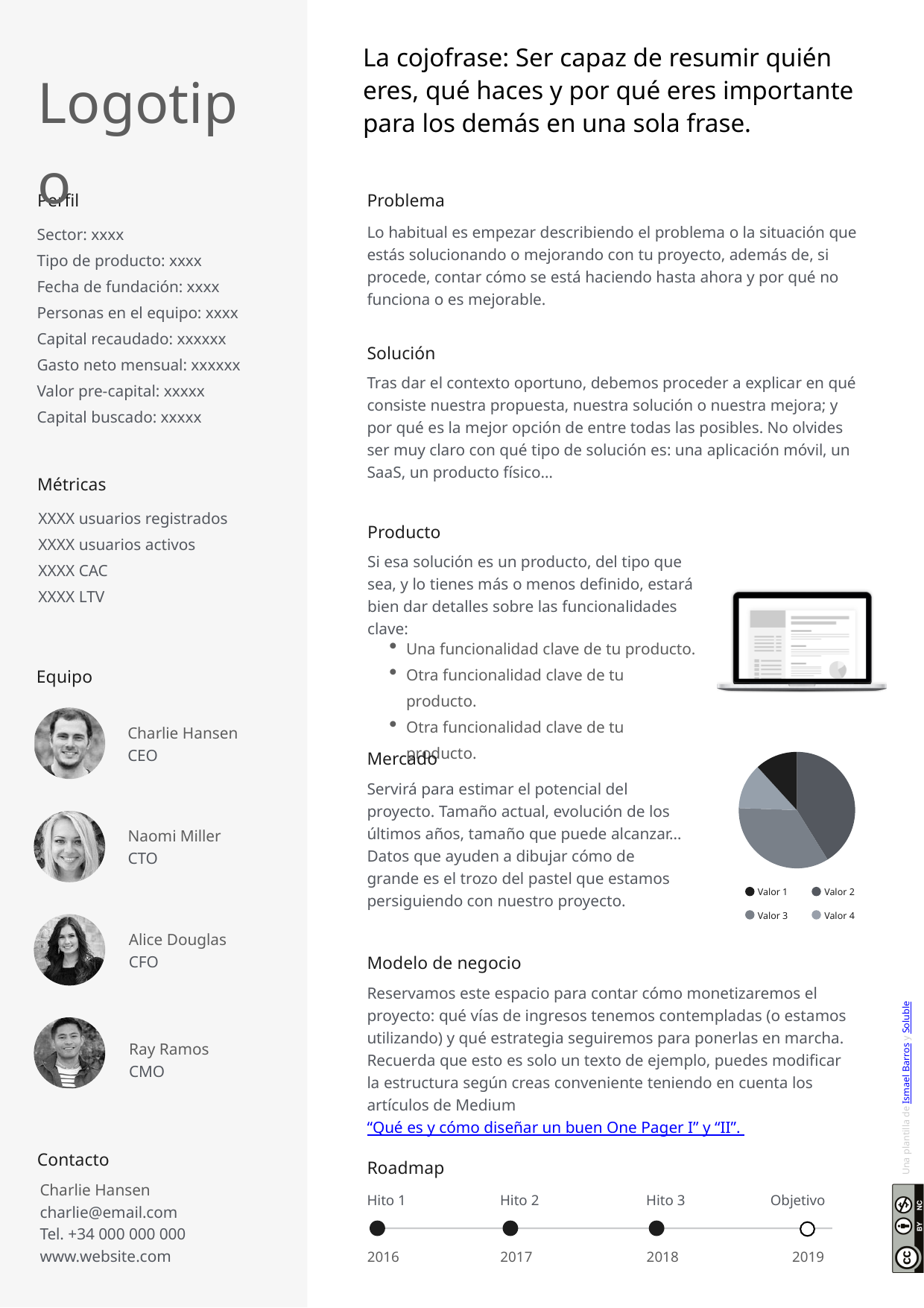
In the pie chart, which is larger, Valor 3 or Valor 4? Valor 3 In the pie chart, which is larger, Valor 3 or Valor 1? Valor 3 How many slices does the pie chart have? 4 Which slice of the pie chart is the largest? Valor 2 What colour is the Valor 1 slice in the pie chart? black How many entries does the legend of the pie chart list? 4 What kind of chart is shown in the Mercado section of the slide? pie chart In the pie chart, which is larger, Valor 2 or Valor 4? Valor 2 What are the legend entries of the pie chart? Valor 1, Valor 2, Valor 3, Valor 4